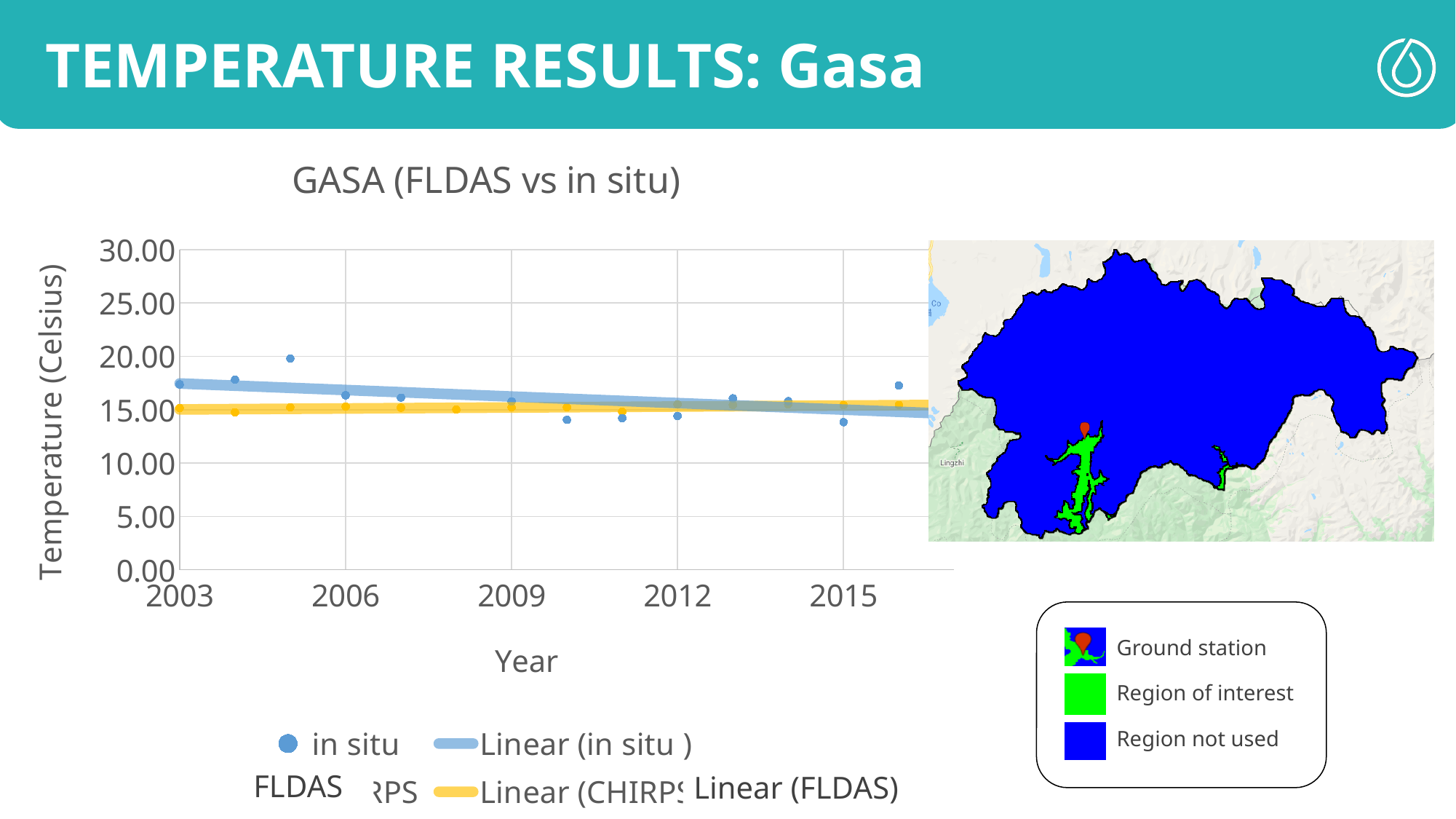
Which is larger in 2005, the in situ value or the FLDAS value? in situ What is the title of the chart? GASA (FLDAS vs in situ) Does the Linear (in situ) trendline rise or fall from 2003 to 2016? fall Is the FLDAS value for 2003 greater or less than 20.00? less Is the in situ value for 2015 greater or less than 15.00? less In which year is the in situ temperature highest? 2005 What is the label of the vertical axis of the chart? Temperature (Celsius) Is the in situ value for 2005 greater or less than 15.00? greater What kind of chart is shown on the slide? scatter chart Which is larger, the in situ value for 2005 or the in situ value for 2003? 2005